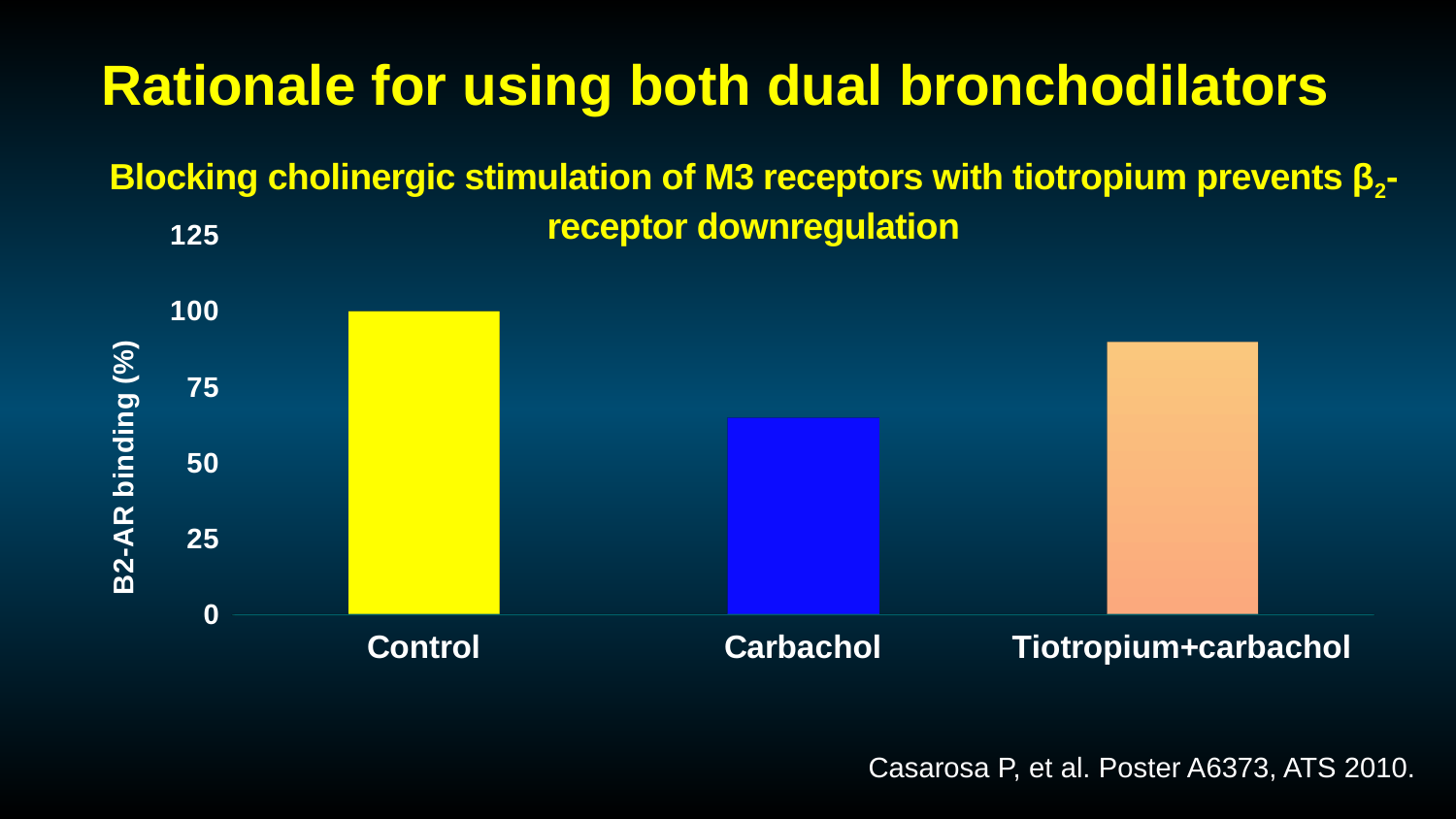
Which category has the lowest B2-AR binding (%)? Carbachol How many categories are plotted on the x axis of the chart? 3 Which category has the highest B2-AR binding (%)? Control Is the value for Carbachol greater or less than 75? less Which is larger, the value for Carbachol or the value for Tiotropium+carbachol? Tiotropium+carbachol What is the B2-AR binding (%) value for Control? 100 What colour is the Carbachol bar? blue What is the label of the y axis of the chart? B2-AR binding (%) Is the value for Carbachol greater or less than 50? greater Is the value for Tiotropium+carbachol greater or less than 100? less What kind of chart is shown on the slide? bar chart